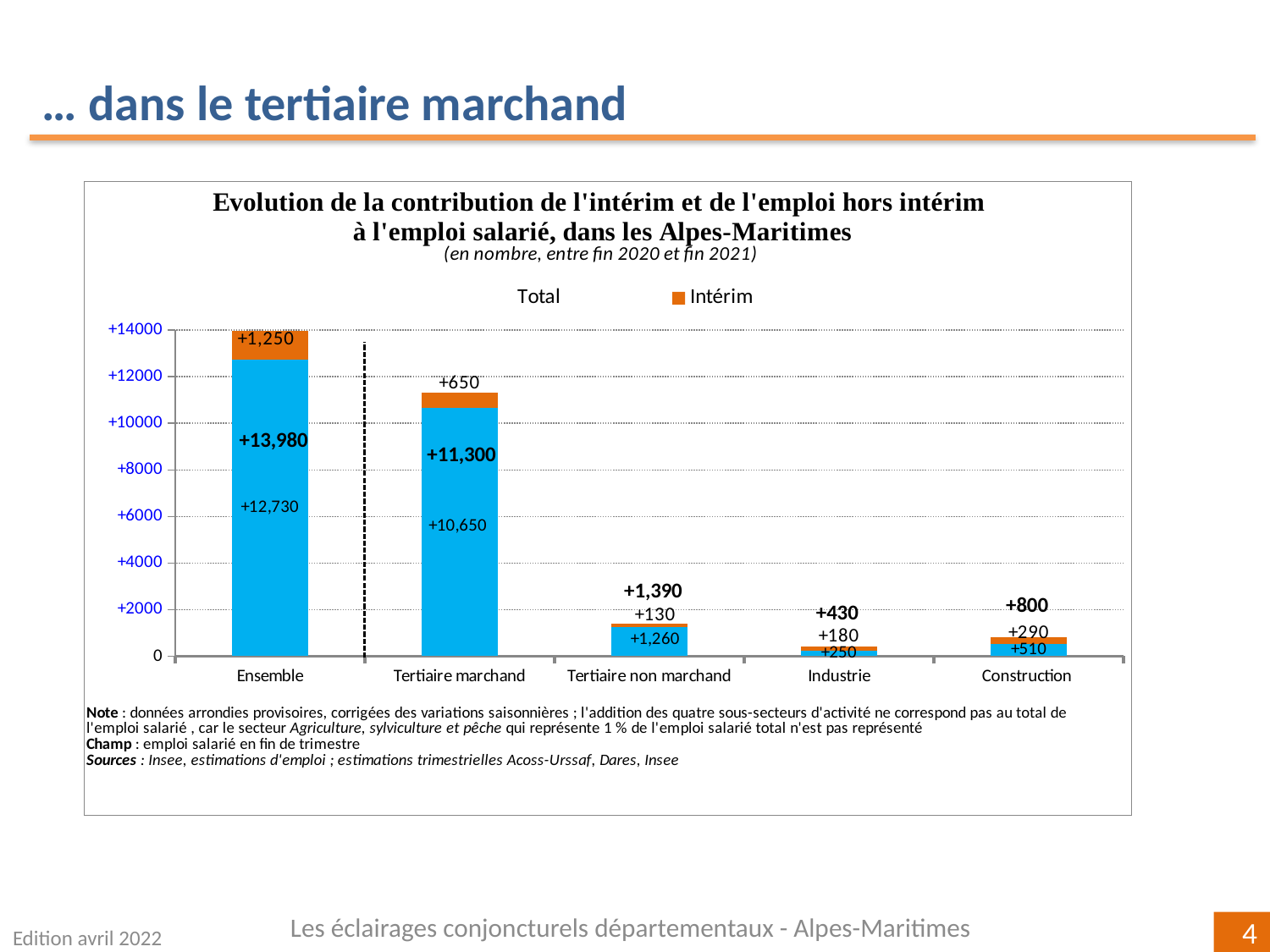
How many categories are shown on the x axis? 5 What is the total of the stacked bar for Industrie? +430 Which category has the highest total value? Ensemble What is the total value shown above the Tertiaire marchand bar? +11,300 What colour represents the Intérim series in the legend? Orange Which is larger, the Intérim value for Industrie or the Intérim value for Construction? Construction What is the difference between the total for Ensemble and the total for Tertiaire marchand? 2,680 What kind of chart is this? Stacked bar chart Which category has the lowest total value? Industrie What is the Intérim value for Ensemble? +1,250 What is the value of the blue segment for Tertiaire non marchand? +1,260 What is the Intérim value for Construction? +290